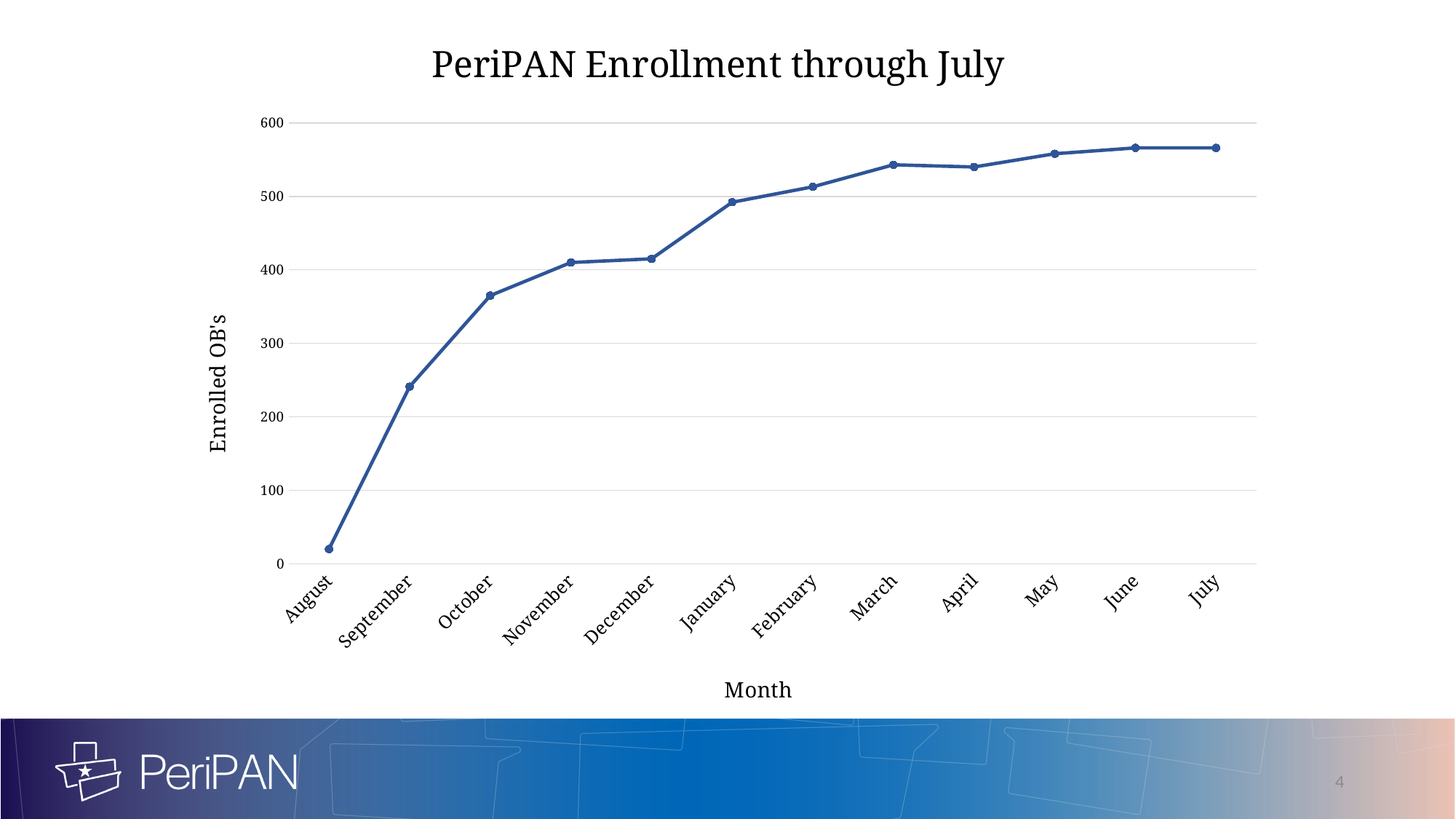
Which month has the lowest number of enrolled OB's? August Do the enrolled OB's generally rise or fall from August to July? rise What kind of chart is shown on the slide? line chart What is the label of the vertical axis? Enrolled OB's How many months are plotted on the x axis? 12 Is the value for August greater or less than 100? less Which month has more enrolled OB's, September or October? October Is the value for July greater or less than 600? less What is the title of the chart? PeriPAN Enrollment through July Is the value for September greater or less than 200? greater Which month has more enrolled OB's, December or January? January